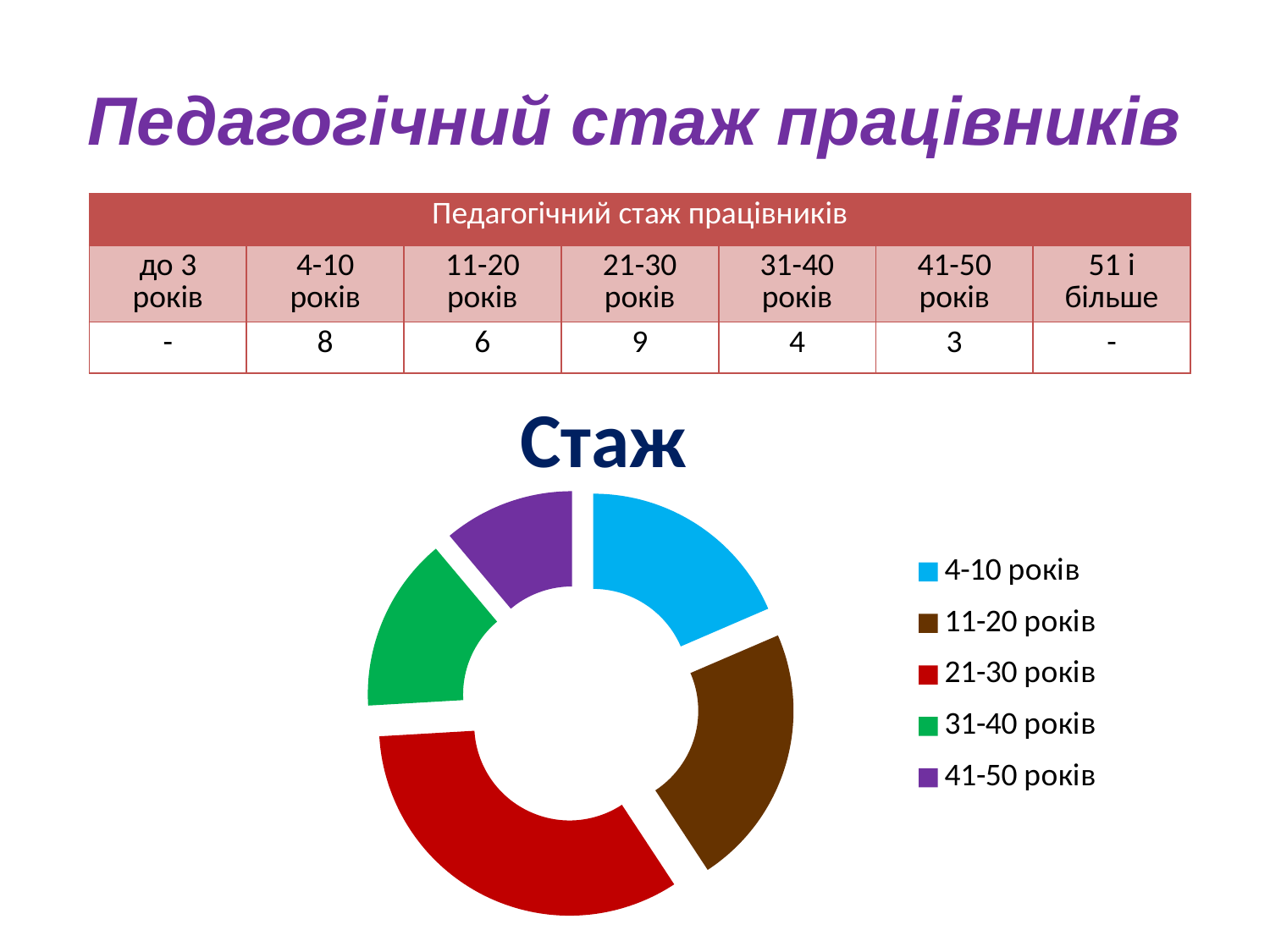
Which category has the largest slice in the "Стаж" chart? 21-30 років Which slice is larger in the "Стаж" chart: 31-40 років or 11-20 років? 11-20 років What colour is the 21-30 років slice in the "Стаж" chart? Red How many categories does the legend of the "Стаж" chart list? 5 Which category has the smallest slice in the "Стаж" chart? 41-50 років How many slices does the "Стаж" doughnut chart have? 5 According to the table, how many employees have 4-10 років of teaching experience? 8 Which slice is larger in the "Стаж" chart: 4-10 років or 11-20 років? 11-20 років What type of chart is shown under the title "Стаж"? Doughnut chart Using the table values, what is the difference between the 21-30 років and 41-50 років categories? 6 According to the table, how many employees have 21-30 років of teaching experience? 9 What is the title of the doughnut chart? Стаж